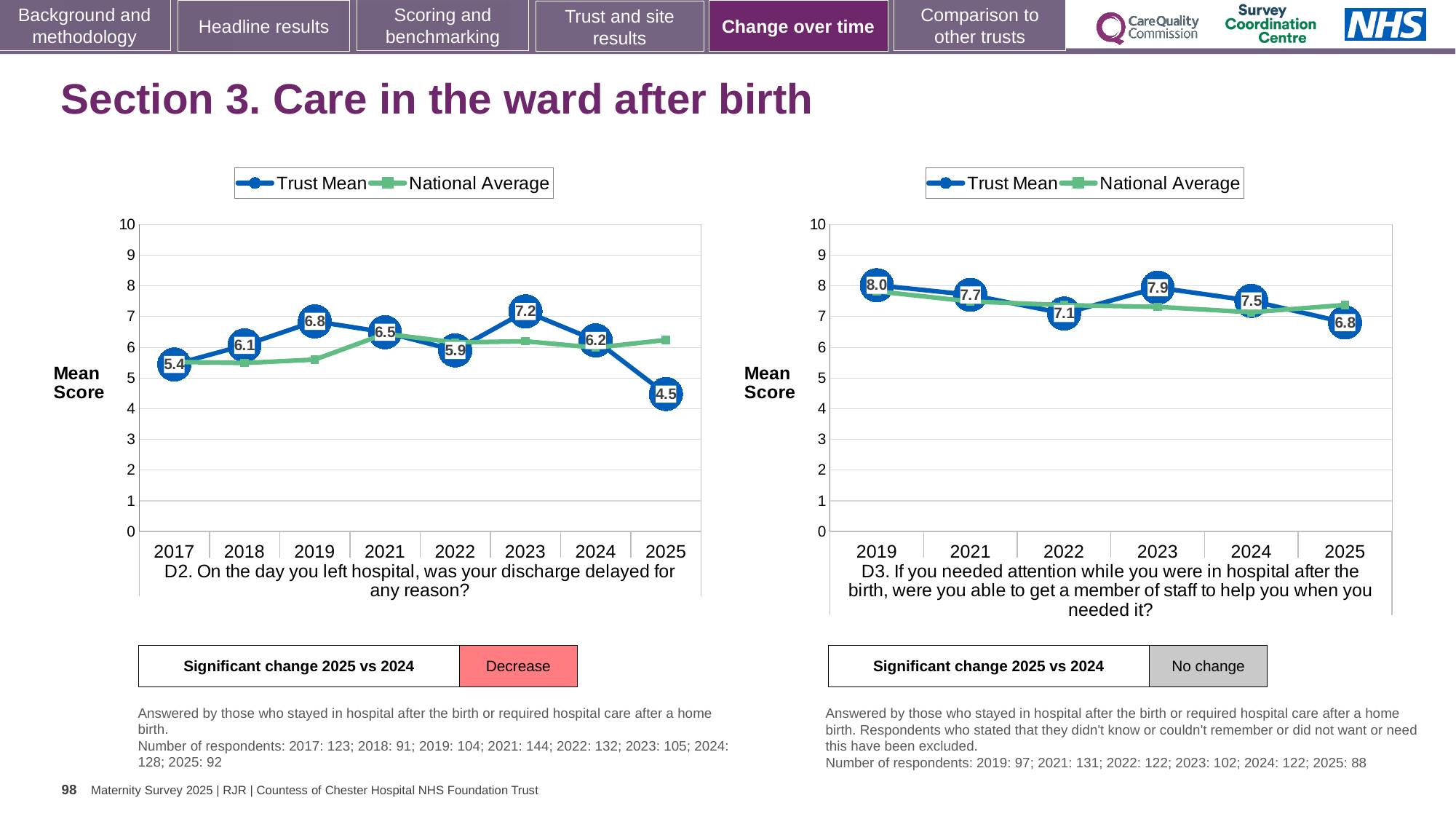
In the D3 chart (right), what is the Trust Mean score for 2022? 7.1 In the D3 chart (right), does the Trust Mean rise or fall from 2024 to 2025? Fall In the D2 chart (left), what is the Trust Mean score for 2017? 5.4 In the D3 chart (right), which is larger, the Trust Mean score for 2019 or for 2023? 2019 How many series does the legend of the D3 chart (right) list? 2 In the D3 chart (right), is the National Average for 2025 greater or less than 7? greater In the D2 chart (left), which year has the highest Trust Mean score? 2023 In the D3 chart (right), which year has the lowest Trust Mean score? 2025 How many years are plotted on the x axis of the D2 chart (left)? 8 What type of chart is the D3 chart (right)? Line chart In the D2 chart (left), what is the difference between the Trust Mean scores for 2024 and 2025? 1.7 In the D2 chart (left), what is the Trust Mean score for 2025? 4.5